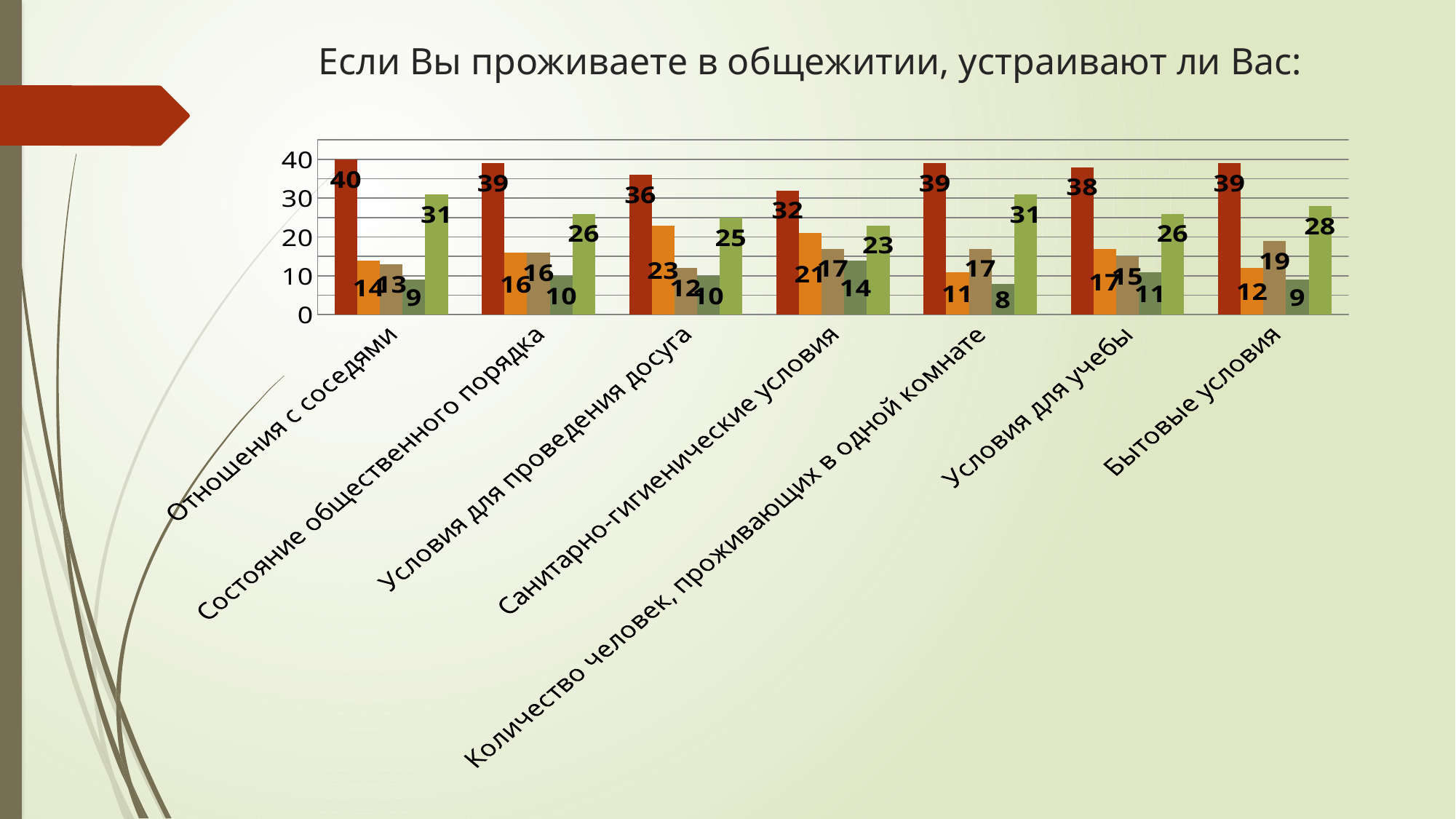
What is the title of the chart on the slide? Если Вы проживаете в общежитии, устраивают ли Вас: What is the value of the orange bar for "Условия для проведения досуга"? 23 Which category has the lowest dark red bar? Санитарно-гигиенические условия What is the value of the dark green bar for "Количество человек, проживающих в одной комнате"? 8 Is the light green bar for "Состояние общественного порядка" greater or less than 30? less What is the value of the dark red bar for "Отношения с соседями"? 40 What is the value of the light green bar for "Бытовые условия"? 28 What type of chart is shown on the slide? bar chart How many categories are shown on the x axis of the chart? 7 What is the difference between the dark red bar and the light green bar for "Условия для учебы"? 12 Which category has the highest dark red bar? Отношения с соседями Which is larger for "Санитарно-гигиенические условия": the orange bar or the tan bar? the orange bar